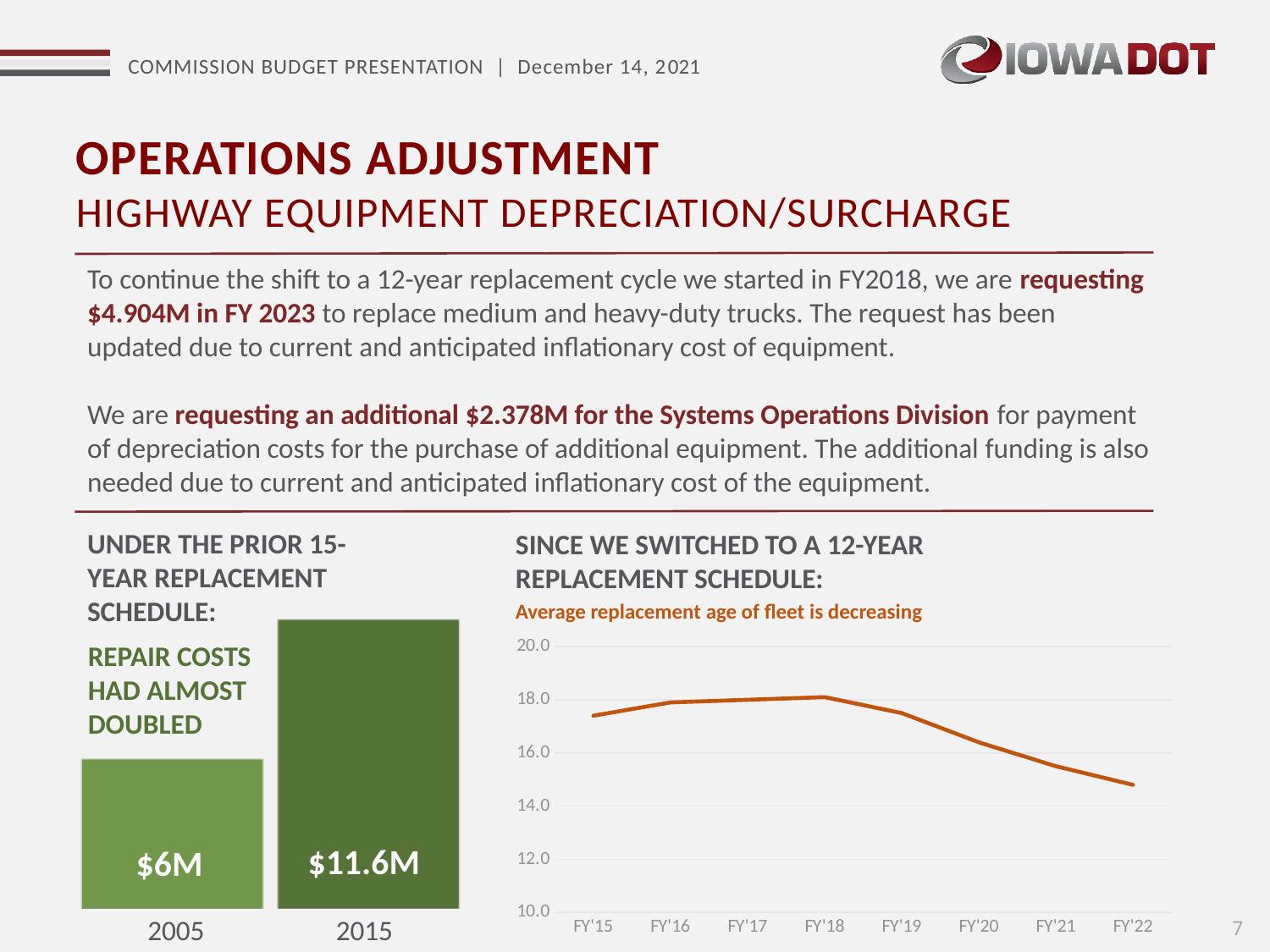
On the 'Average replacement age of fleet is decreasing' chart, which fiscal year has the lowest value? FY'22 How many bars are shown on the left bar chart? 2 What kind of chart is the chart on the left of the slide? Bar chart What kind of chart is the 'Average replacement age of fleet is decreasing' chart? Line chart On the 'Average replacement age of fleet is decreasing' chart, is the value for FY'18 greater or less than 16.0? greater On the left bar chart, which year has the higher repair costs? 2015 On the 'Average replacement age of fleet is decreasing' chart, is the value for FY'22 greater or less than 16.0? less On the left bar chart, what were the repair costs in 2005? $6M On the 'Average replacement age of fleet is decreasing' chart, do the values rise or fall from FY'18 to FY'22? Fall How many fiscal years are plotted on the 'Average replacement age of fleet is decreasing' chart? 8 On the left bar chart, what is the difference between the 2015 and 2005 repair costs? $5.6M On the left bar chart, what were the repair costs in 2015? $11.6M